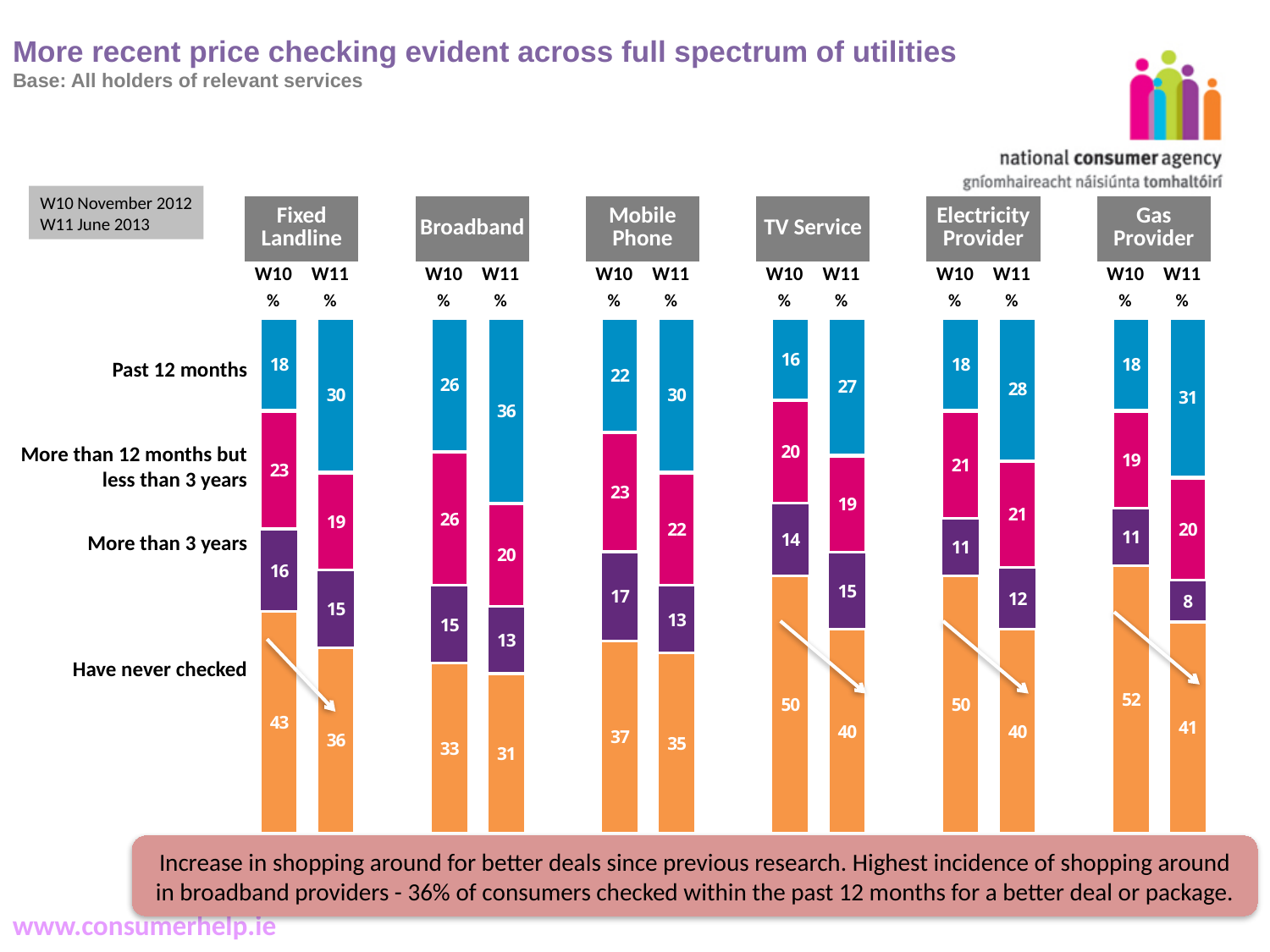
What is the W11 value for 'More than 3 years' for Gas Provider? 8% What is the total of the Fixed Landline W10 stacked bar? 100 How many utility services are shown in the chart? 6 Which utility has the lowest 'Past 12 months' value in W10? TV Service For Fixed Landline, by how many percentage points did 'Have never checked' fall from W10 to W11? 7 Which survey date does W11 represent? June 2013 What percentage of Broadband holders checked prices in the past 12 months in W11? 36% What percentage of TV Service holders had never checked prices in W10? 50% In W11, which has the larger 'Past 12 months' value: Electricity Provider or Gas Provider? Gas Provider Which utility has the highest 'Past 12 months' value in W11? Broadband What kind of chart is shown on the slide? Stacked bar chart For Mobile Phone, does the 'Have never checked' value rise or fall from W10 to W11? Fall